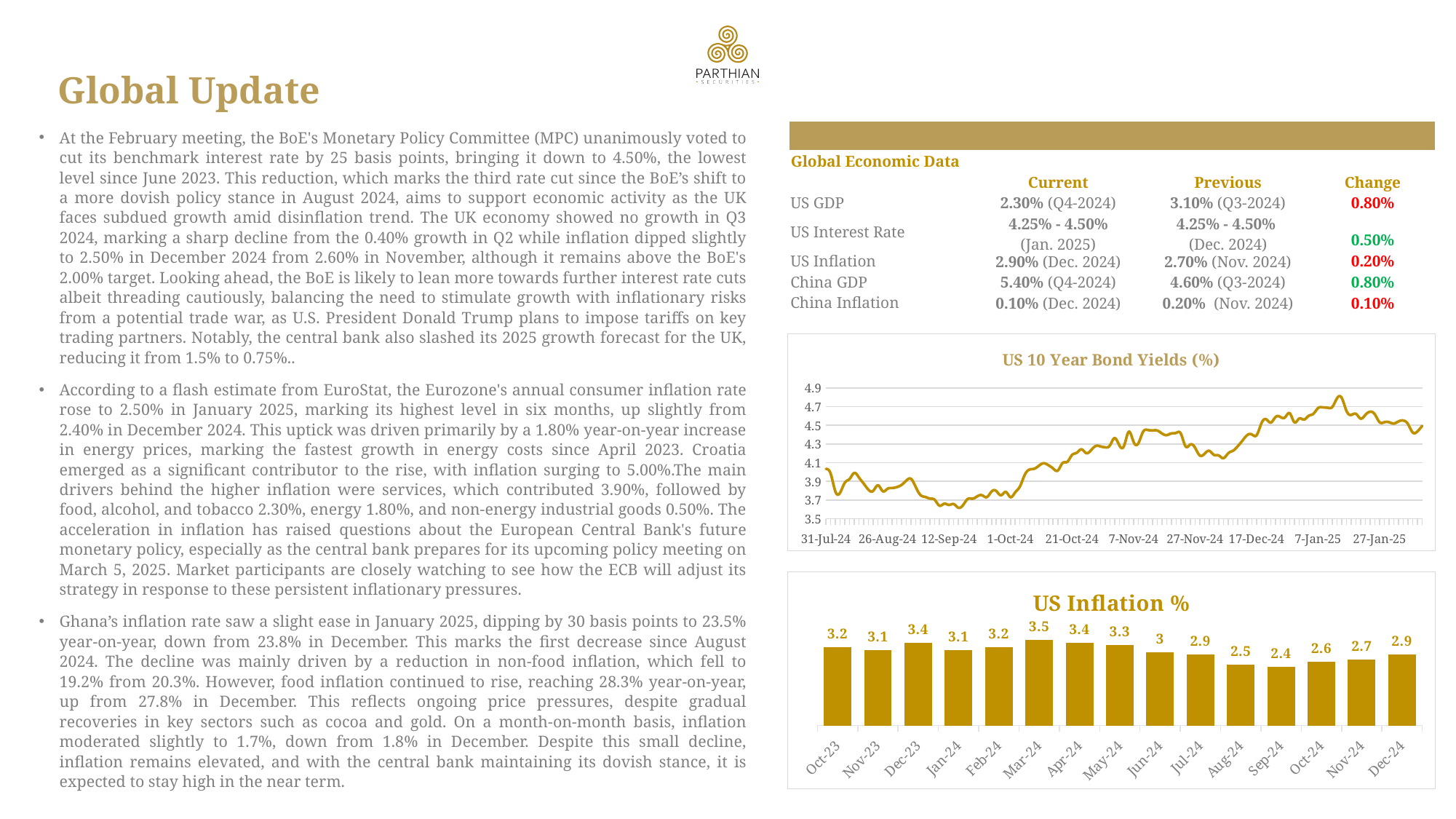
On the US 10 Year Bond Yields (%) chart, is the peak value in early January 2025 greater or less than 4.5? greater On the US Inflation % chart, which month has the highest value? Mar-24 On the US Inflation % chart, what is the difference between the values for Mar-24 and Sep-24? 1.1 What kind of chart is the US 10 Year Bond Yields (%) chart? Line chart On the US Inflation % chart, which month has the lowest value? Sep-24 On the US 10 Year Bond Yields (%) chart, is the value around 1-Oct-24 greater or less than 4.1? less On the US Inflation % chart, which is larger, the value for Dec-23 or the value for Jun-24? Dec-23 On the US Inflation % chart, what is the value for Mar-24? 3.5 How many months are shown on the US Inflation % chart? 15 On the US Inflation % chart, what is the value for Sep-24? 2.4 What kind of chart is the US Inflation % chart? Bar chart On the US 10 Year Bond Yields (%) chart, do yields overall rise or fall from 31-Jul-24 to 27-Jan-25? Rise